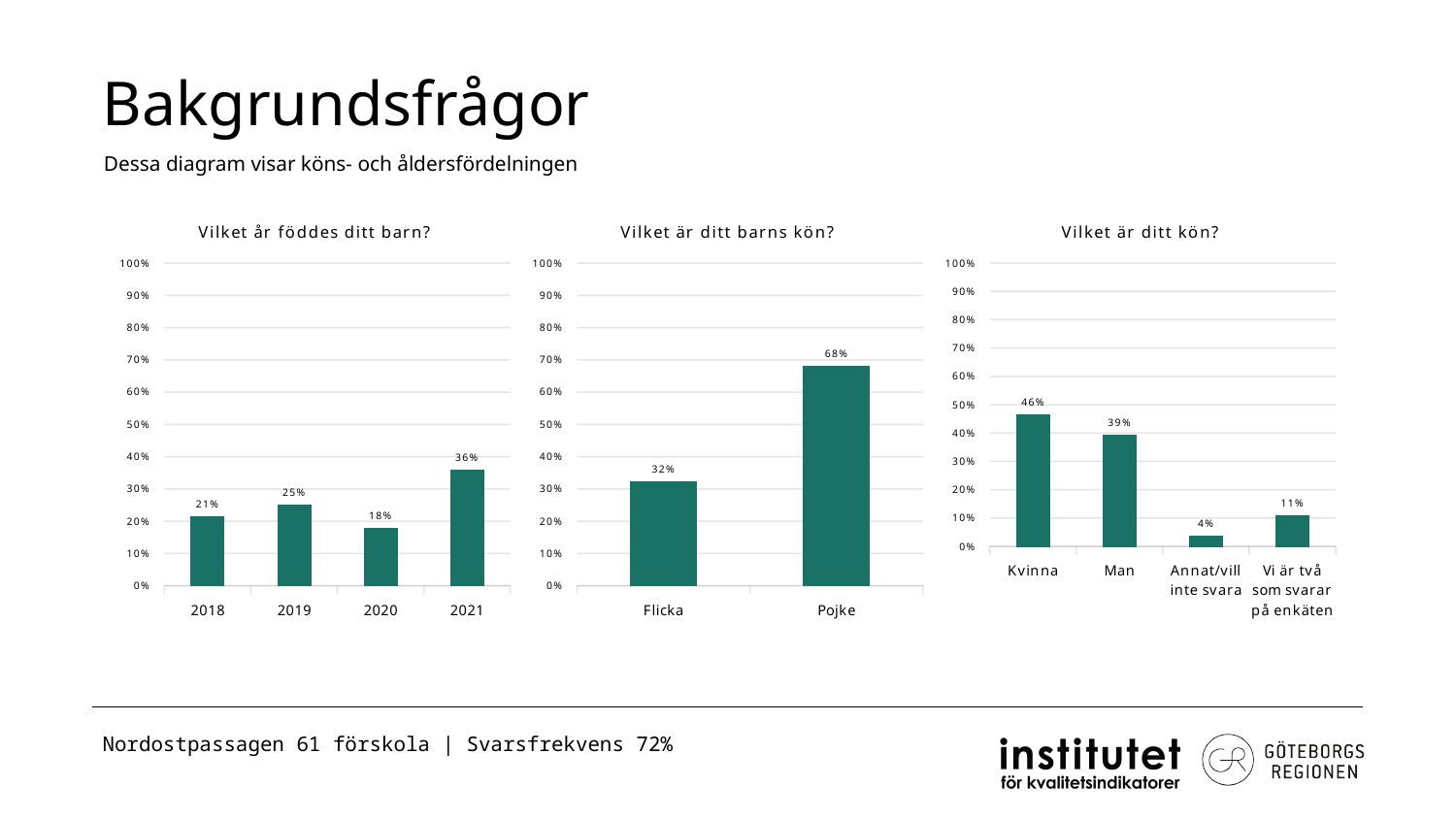
In the chart 'Vilket är ditt barns kön?', what is the difference between Pojke and Flicka? 36% In the chart 'Vilket år föddes ditt barn?', what is the value for 2019? 25% In the chart 'Vilket år föddes ditt barn?', which year has the highest value? 2021 In the chart 'Vilket är ditt barns kön?', which category is larger, Flicka or Pojke? Pojke In the chart 'Vilket är ditt kön?', is the value for Kvinna greater or less than 40%? greater In the chart 'Vilket är ditt barns kön?', what is the value for Pojke? 68% In the chart 'Vilket år föddes ditt barn?', what is the difference between the values for 2021 and 2018? 15% In the chart 'Vilket är ditt kön?', which category has the lowest value? Annat/vill inte svara In the chart 'Vilket år föddes ditt barn?', which year has the lowest value? 2020 In the chart 'Vilket år föddes ditt barn?', how many years are shown on the x axis? 4 In the chart 'Vilket är ditt kön?', what is the value for Man? 39% What kind of chart is 'Vilket är ditt kön?'? Bar chart